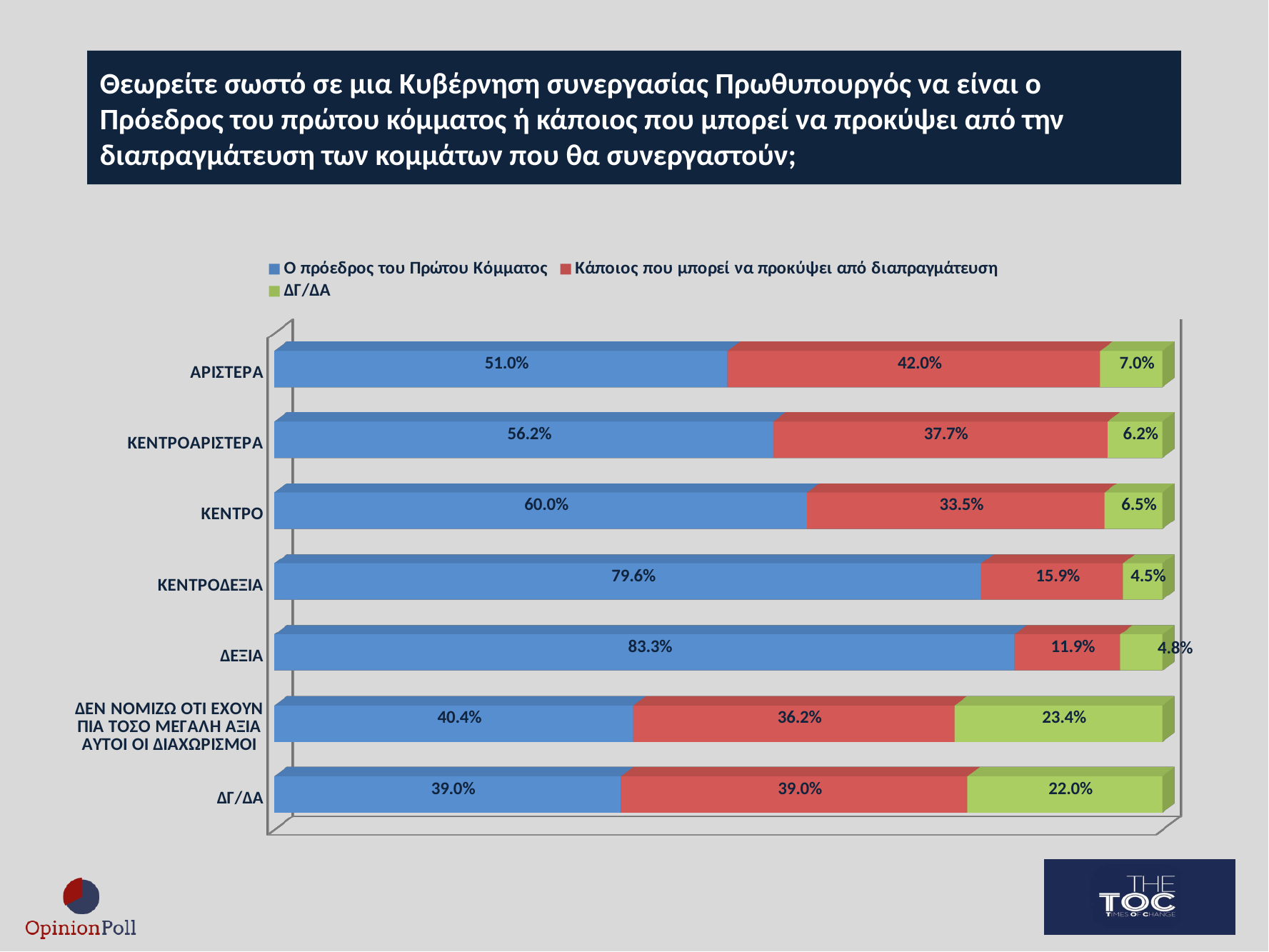
What is the difference between the 'Ο πρόεδρος του Πρώτου Κόμματος' values for ΚΕΝΤΡΟΔΕΞΙΑ and ΚΕΝΤΡΟ? 19.6% How many series does the legend list? 3 Which category has the highest ΔΓ/ΔΑ value? ΔΕΝ ΝΟΜΙΖΩ ΟΤΙ ΕΧΟΥΝ ΠΙΑ ΤΟΣΟ ΜΕΓΑΛΗ ΑΞΙΑ ΑΥΤΟΙ ΟΙ ΔΙΑΧΩΡΙΣΜΟΙ Which is larger for ΚΕΝΤΡΟΑΡΙΣΤΕΡΑ: 'Ο πρόεδρος του Πρώτου Κόμματος' or 'Κάποιος που μπορεί να προκύψει από διαπραγμάτευση'? Ο πρόεδρος του Πρώτου Κόμματος Which category has the lowest value for 'Ο πρόεδρος του Πρώτου Κόμματος'? ΔΓ/ΔΑ What is the value for 'Κάποιος που μπορεί να προκύψει από διαπραγμάτευση' in the ΑΡΙΣΤΕΡΑ category? 42.0% How many categories are shown on the vertical axis? 7 What is the ΔΓ/ΔΑ value for the ΚΕΝΤΡΟ category? 6.5% Which category has the highest value for 'Ο πρόεδρος του Πρώτου Κόμματος'? ΔΕΞΙΑ Which colour represents the ΔΓ/ΔΑ series in the chart? Green What type of chart is shown on the slide? Stacked bar chart What is the value for 'Ο πρόεδρος του Πρώτου Κόμματος' in the ΔΕΞΙΑ category? 83.3%